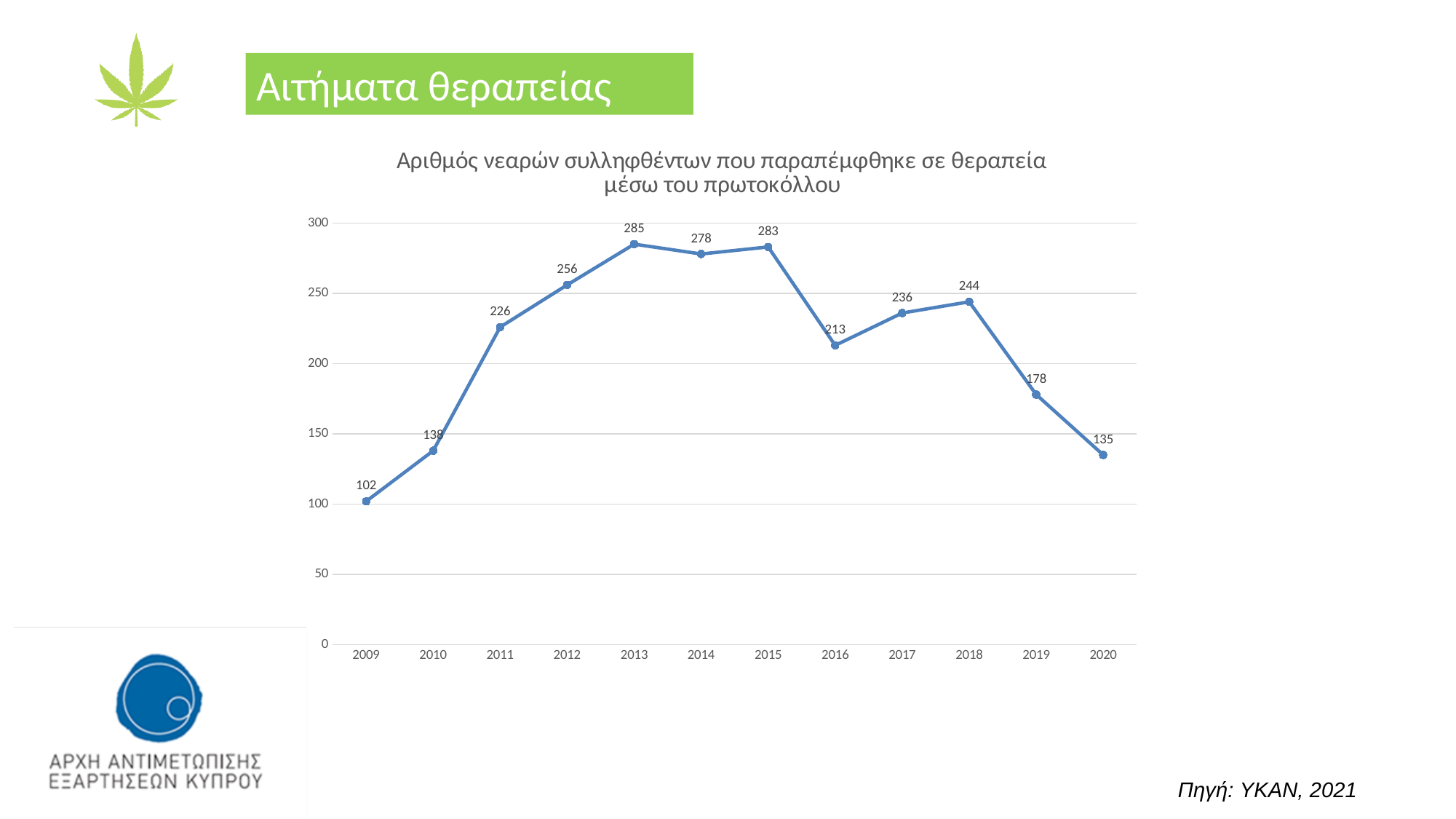
What value is shown for 2009? 102 Which year has the highest value? 2013 What value is shown for 2013? 285 Do the values rise or fall from 2018 to 2020? fall Is the value for 2020 greater or less than 150? less What is the difference between the values for 2013 and 2020? 150 What is the difference between the values for 2018 and 2019? 66 Which year has the lowest value? 2009 How many years are plotted on the x axis? 12 What kind of chart is shown? line chart Which year has the larger value, 2012 or 2017? 2012 What value is shown for 2016? 213